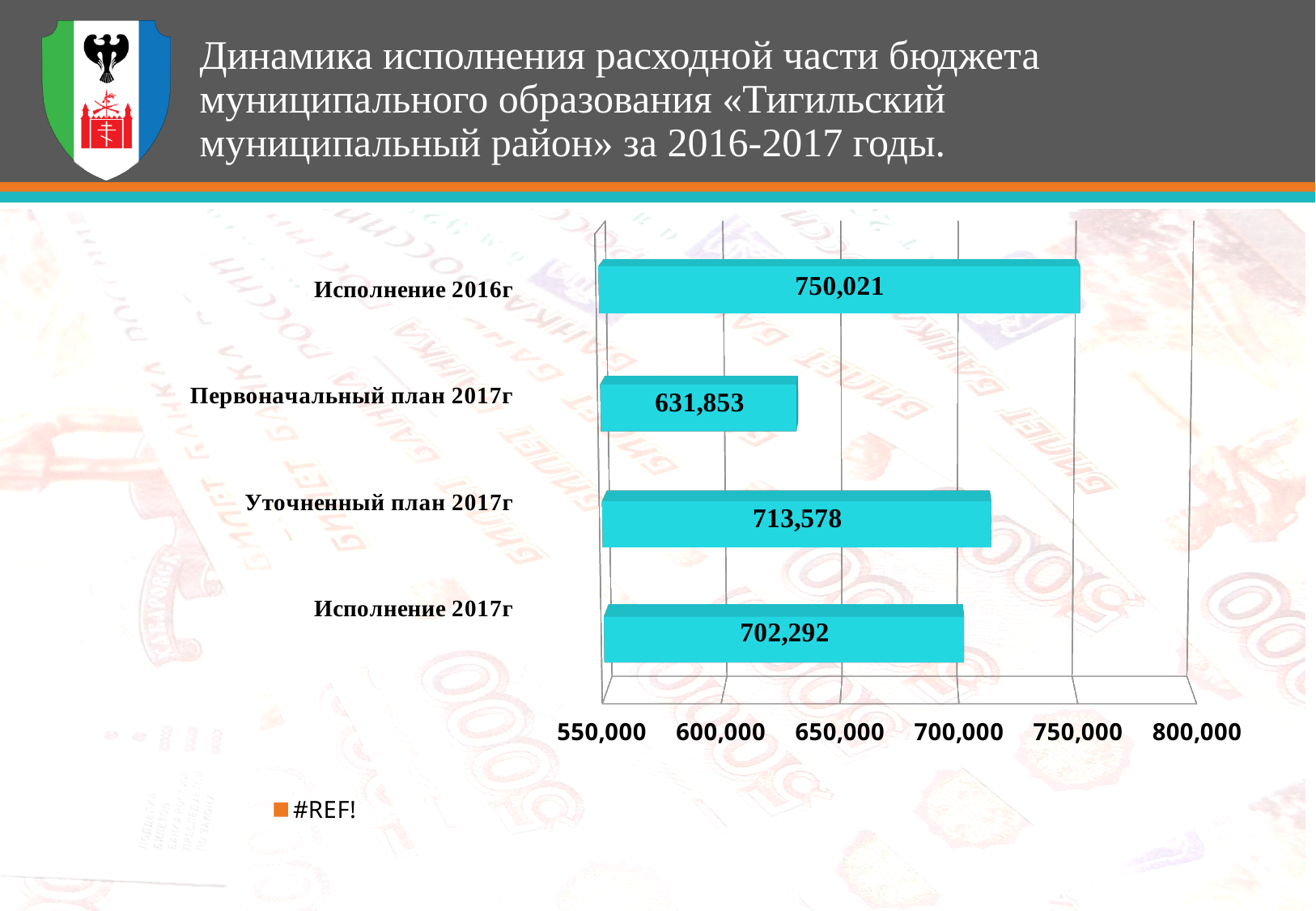
What is the difference between Исполнение 2016г and Исполнение 2017г? 47,729 What kind of chart is shown on the slide? bar chart What is the value for Первоначальный план 2017г? 631,853 What is the difference between Уточненный план 2017г and Первоначальный план 2017г? 81,725 How many categories are shown in the chart? 4 What is the value for Исполнение 2017г? 702,292 What is the value for Уточненный план 2017г? 713,578 Which category has the highest value? Исполнение 2016г Which category has the lowest value? Первоначальный план 2017г What is the value for Исполнение 2016г? 750,021 Which is larger, Уточненный план 2017г or Исполнение 2017г? Уточненный план 2017г Is the value for Первоначальный план 2017г greater or less than 650,000? less